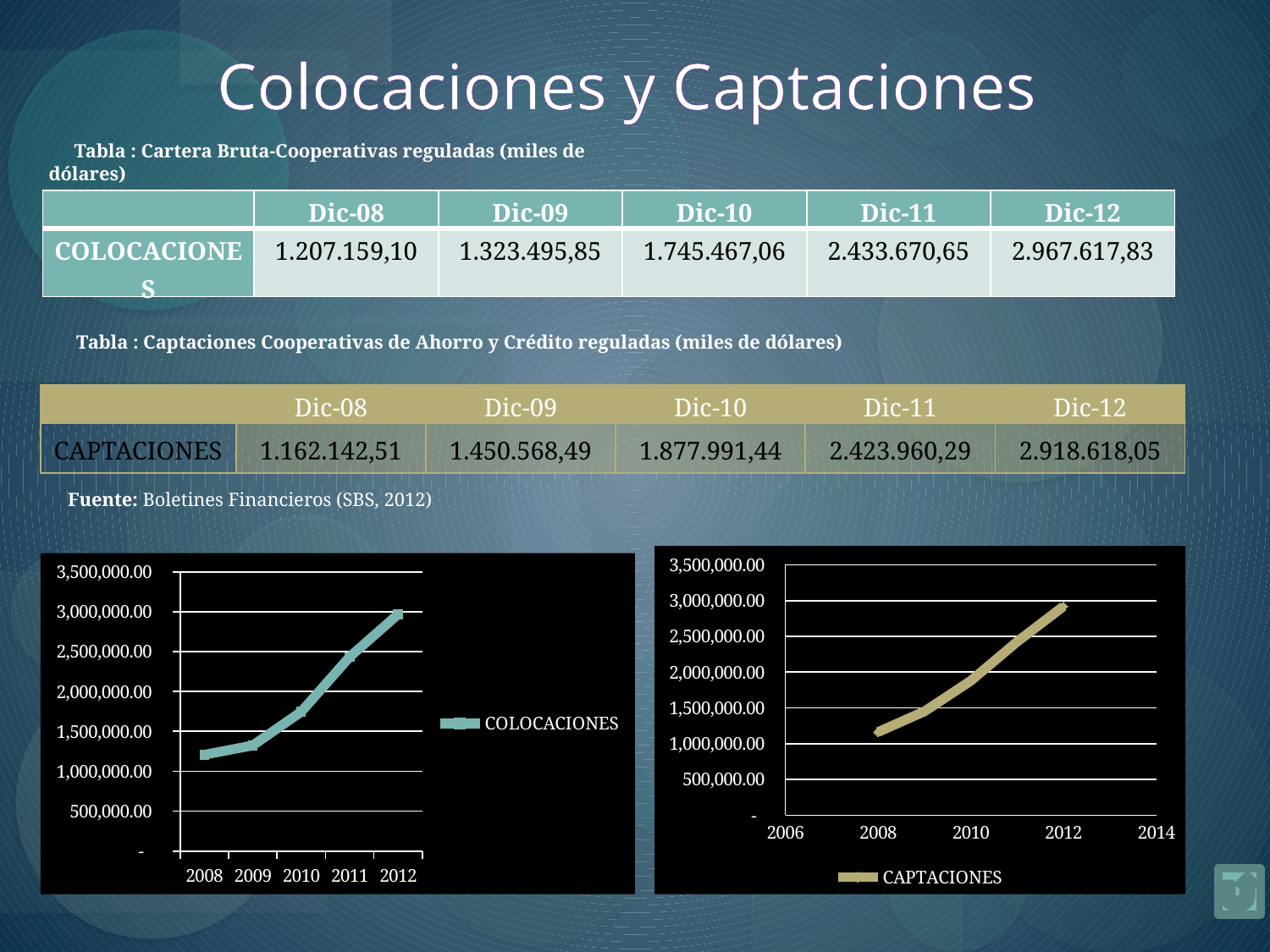
How many series does the legend of the left chart (COLOCACIONES) list? 1 In the left chart (COLOCACIONES), which year has the larger value, 2009 or 2011? 2011 In the right chart (CAPTACIONES), is the value for 2012 greater or less than 2,500,000.00? greater In the left chart (COLOCACIONES), is the value for 2012 greater or less than 2,500,000.00? greater How many series does the legend of the right chart (CAPTACIONES) list? 1 In the left chart (COLOCACIONES), do the values rise or fall from 2008 to 2012? rise In the right chart (CAPTACIONES), is the value for 2008 greater or less than 1,500,000.00? less In the right chart (CAPTACIONES), do the values rise or fall from 2008 to 2012? rise What kind of chart is the right chart labelled CAPTACIONES? line chart What kind of chart is the left chart labelled COLOCACIONES? line chart How many years are labelled on the x axis of the left chart (COLOCACIONES)? 5